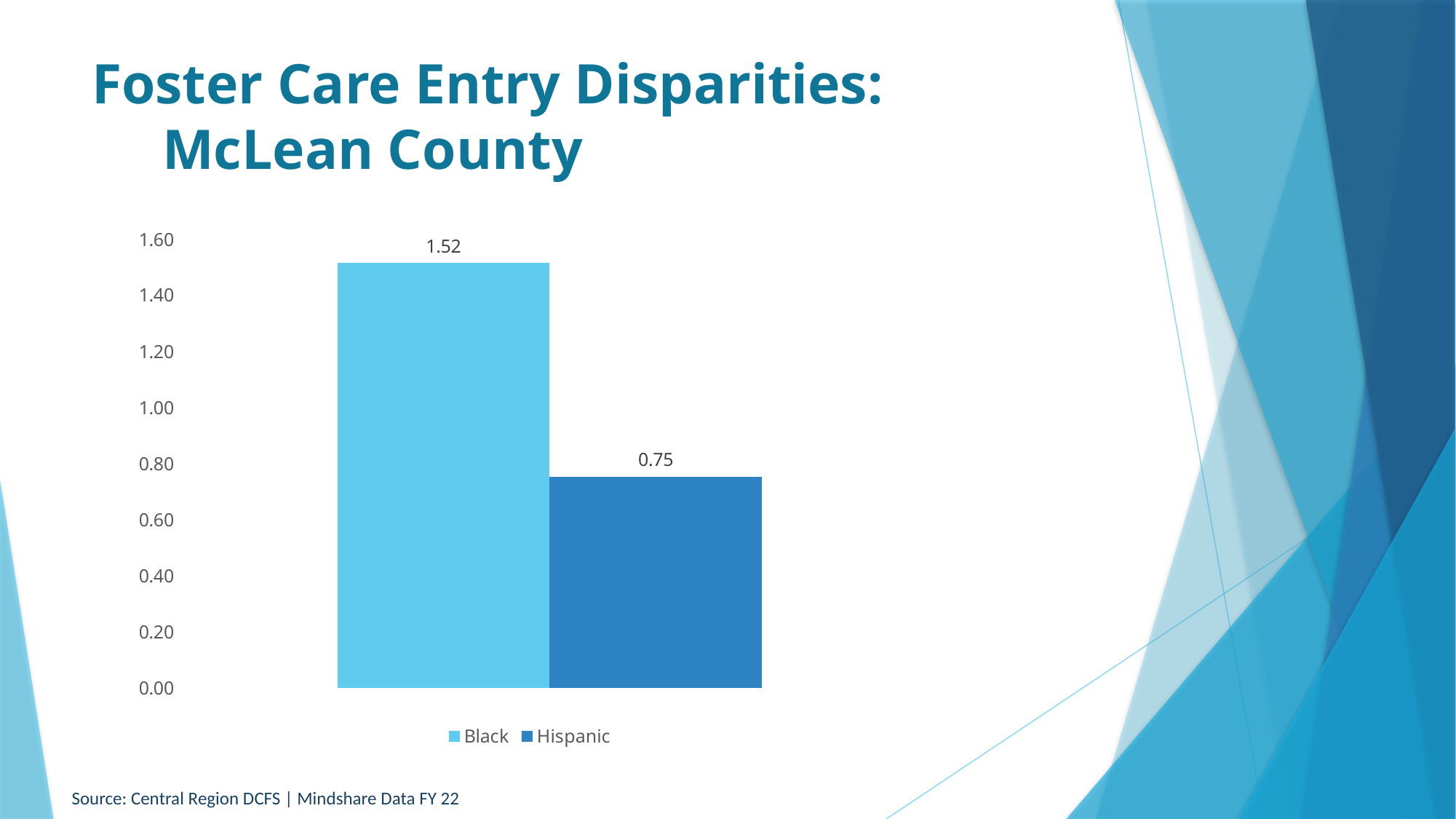
What kind of chart is shown on the slide? bar chart What is the value for Hispanic? 0.75 Which series has the lowest value? Hispanic Is the value for Black greater or less than 1.00? greater What is the value for Black? 1.52 Is the value for Hispanic greater or less than 0.80? less Which is larger, the value for Black or the value for Hispanic? Black What is the difference between the Black and Hispanic values? 0.77 Which series has the highest value? Black What is the highest value shown on the vertical axis? 1.60 What is the title of the slide? Foster Care Entry Disparities: McLean County How many series does the legend list? 2